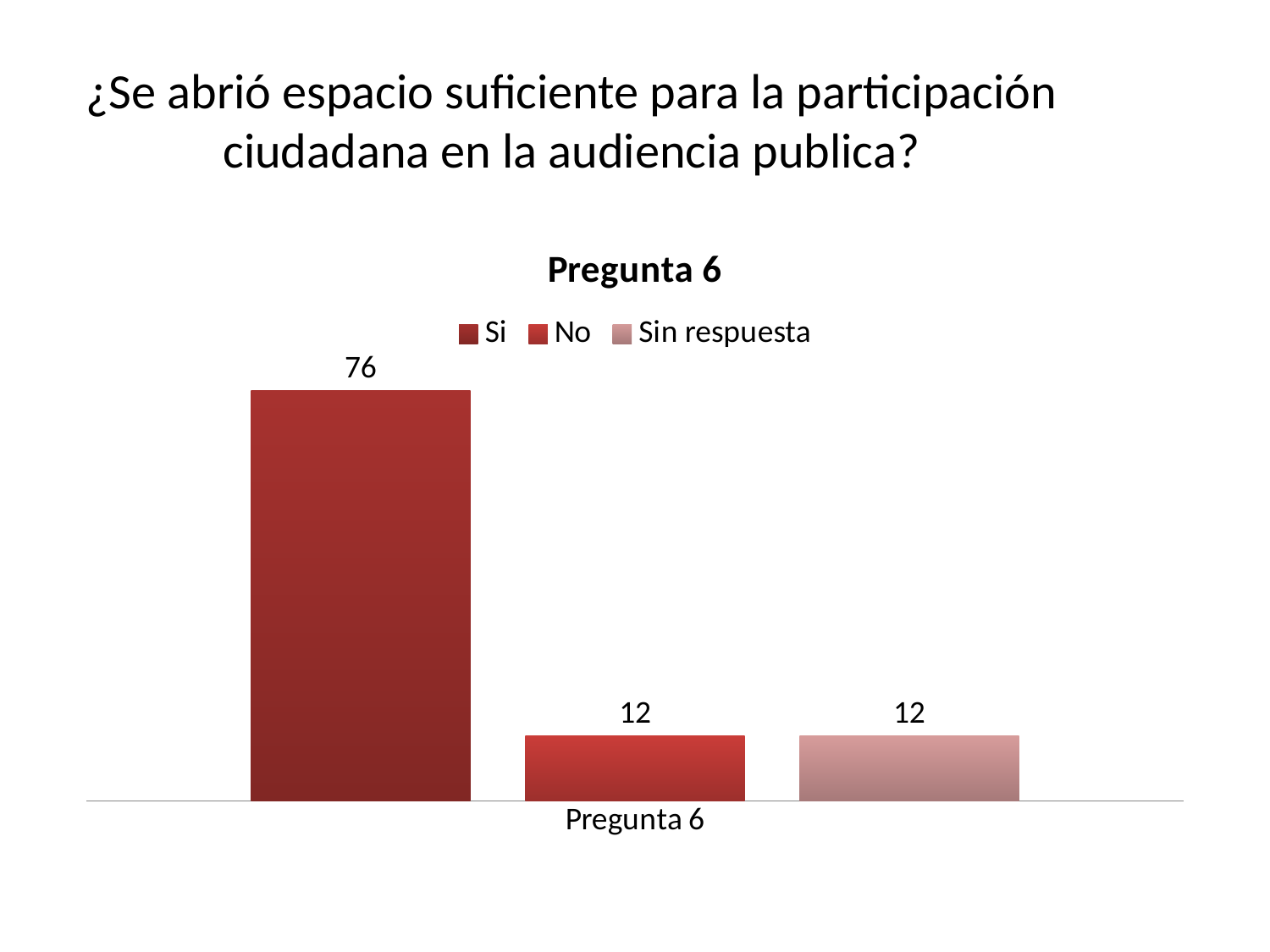
How many series does the legend list? 3 What is the difference between the values for Si and No? 64 Which series has the highest value? Si Which is larger, the value for Si or the value for Sin respuesta? Si What is the title of the chart? Pregunta 6 What is the total of the three values shown in the chart? 100 What is the value for No? 12 What is the value for Sin respuesta? 12 How many bars are plotted in the chart? 3 What kind of chart is shown on the slide? Bar chart What is the category label shown on the x axis? Pregunta 6 What is the value for Si? 76